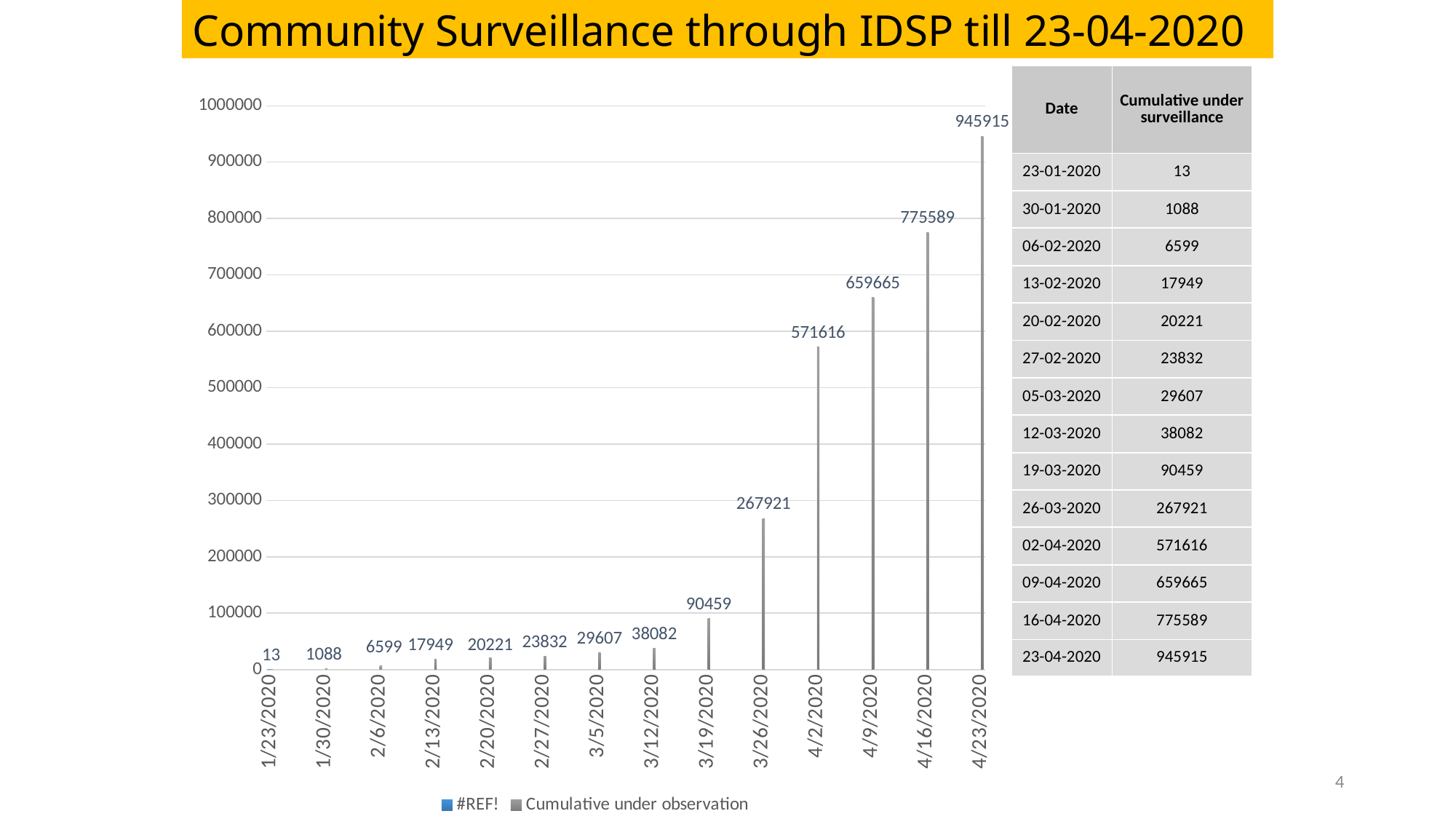
What is the difference between the values for 4/23/2020 and 4/16/2020? 170326 What is the cumulative under observation value for 2/13/2020? 17949 How many dates are plotted on the x axis of the chart? 14 How many series does the chart legend list? 2 What kind of chart is shown on the slide? bar chart What is the cumulative under observation value for 4/23/2020? 945915 Which is larger, the value for 3/19/2020 or the value for 3/12/2020? 3/19/2020 Do the cumulative under observation values rise or fall from 1/23/2020 to 4/23/2020? rise What is the difference between the values for 4/2/2020 and 3/26/2020? 303695 What is the cumulative under observation value for 3/26/2020? 267921 Which date has the lowest cumulative under observation value? 1/23/2020 Which date has the highest cumulative under observation value? 4/23/2020